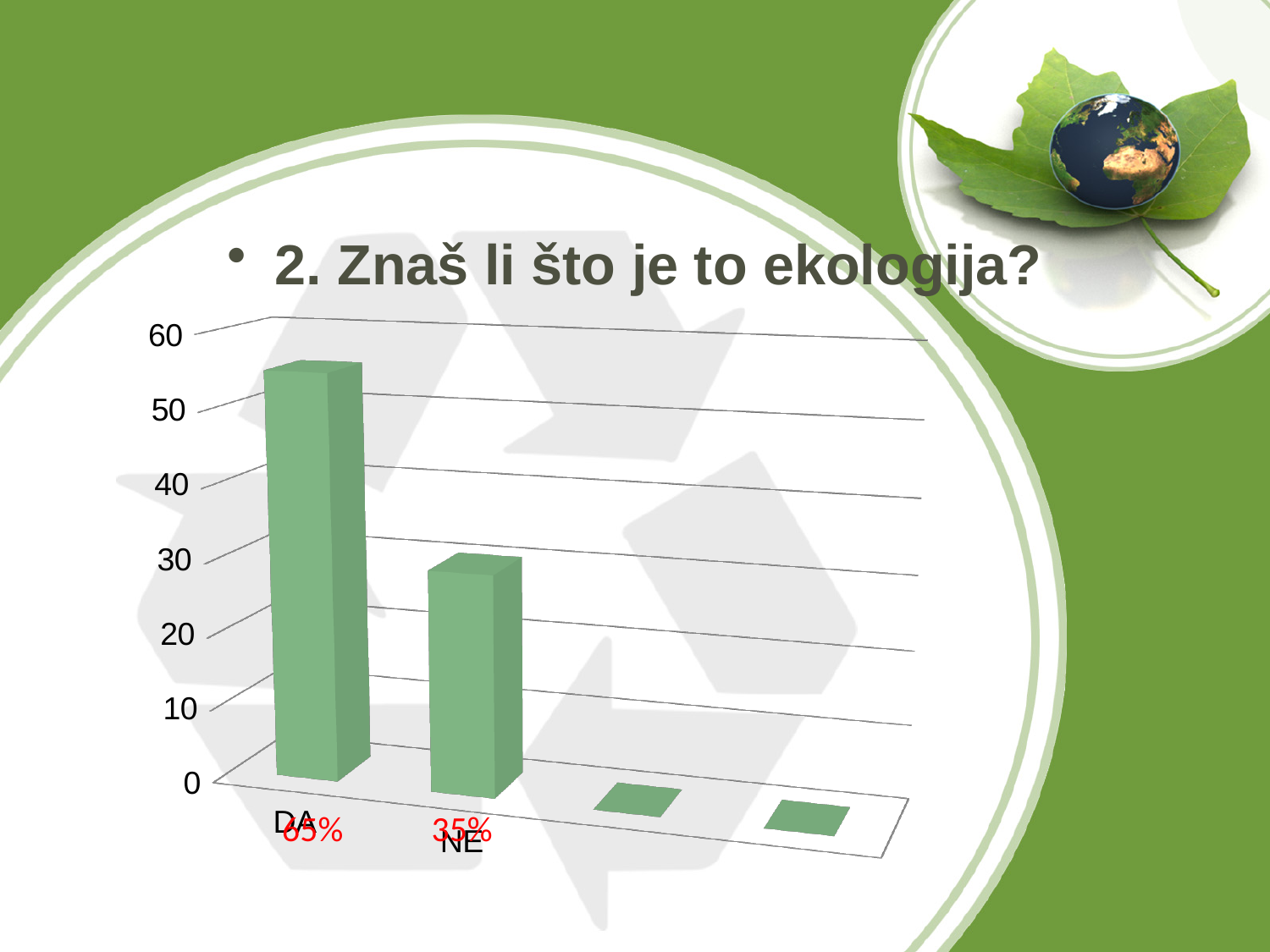
Which of the two labelled categories has the shortest bar? NE Is the value for DA greater or less than 60? less What is the title of the chart on the slide? 2. Znaš li što je to ekologija? Which category has the tallest bar, DA or NE? DA Is the value for NE greater or less than 20? greater What is the highest tick value shown on the vertical axis? 60 Is the value for DA greater or less than 50? greater Do the bar values rise or fall going from DA to NE along the x axis? fall What colour are the bars in the chart? green Is the bar for DA taller or shorter than the bar for NE? taller What kind of chart is shown on the slide? bar chart